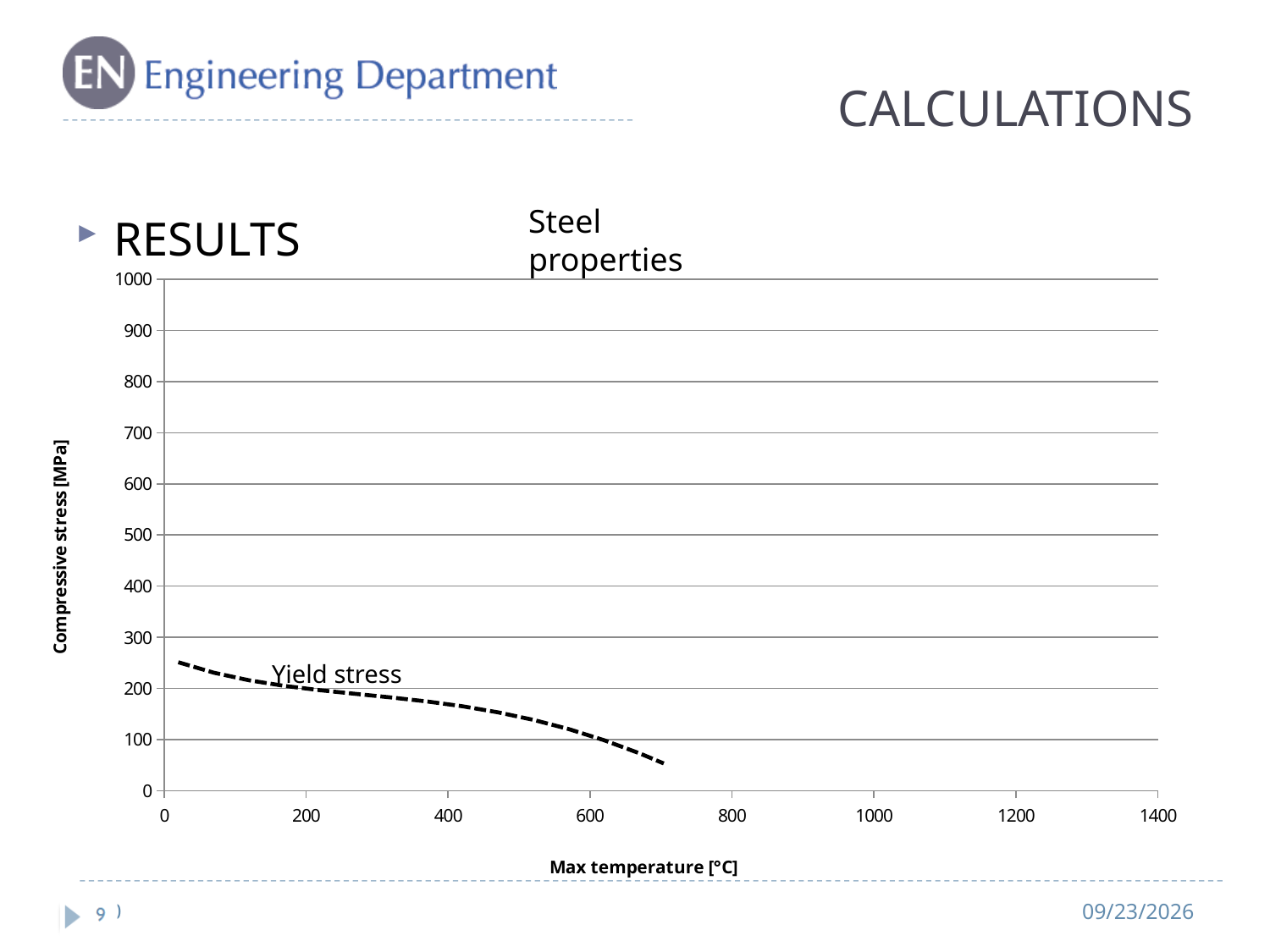
Which series is plotted on the chart? Yield stress What kind of chart is shown on the slide? line chart Is the Yield stress value at a Max temperature of 700 °C greater or less than 100 MPa? less Does the Yield stress curve rise or fall as Max temperature increases? fall Is the Yield stress value at a Max temperature of 200 °C greater or less than 300 MPa? less What is the label of the vertical axis of the chart? Compressive stress [MPa] Is the Yield stress value at a Max temperature of 200 °C greater or less than 100 MPa? greater Is the Yield stress at 200 °C larger or smaller than the Yield stress at 600 °C? larger What is the title of the chart? Steel properties